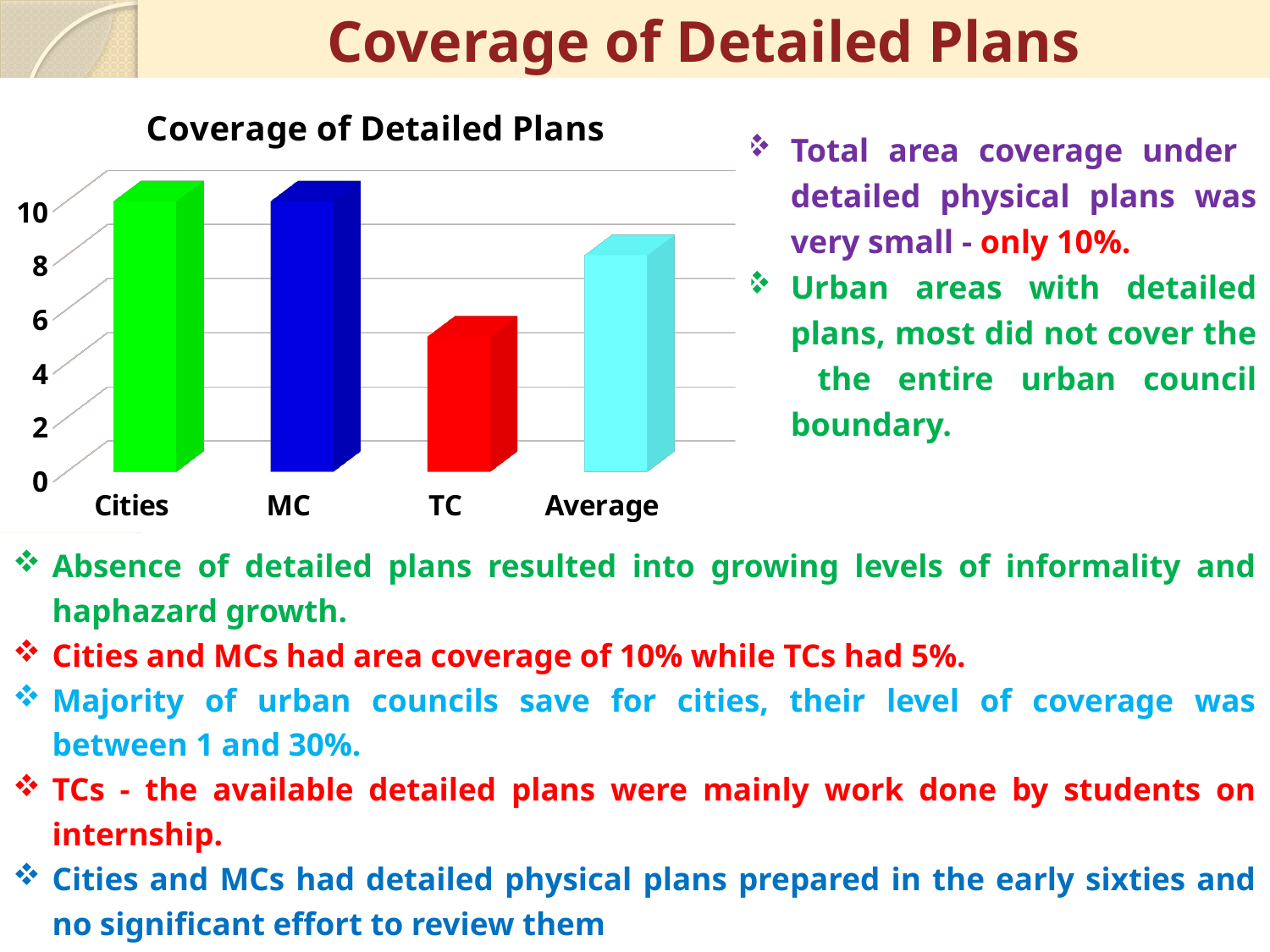
What is the title of the chart? Coverage of Detailed Plans Which is larger, the value for MC or the value for TC? MC Which category has the lowest value in the chart? TC Is the value for TC greater or less than 4? greater What is the value for MC in the chart? 10 Is the value for TC greater or less than 6? less What type of chart is shown on the slide? Bar chart Is the value for Average greater or less than 10? less What is the value for Cities in the chart? 10 How many categories are shown on the x axis of the chart? 4 What colour is the bar for TC? Red